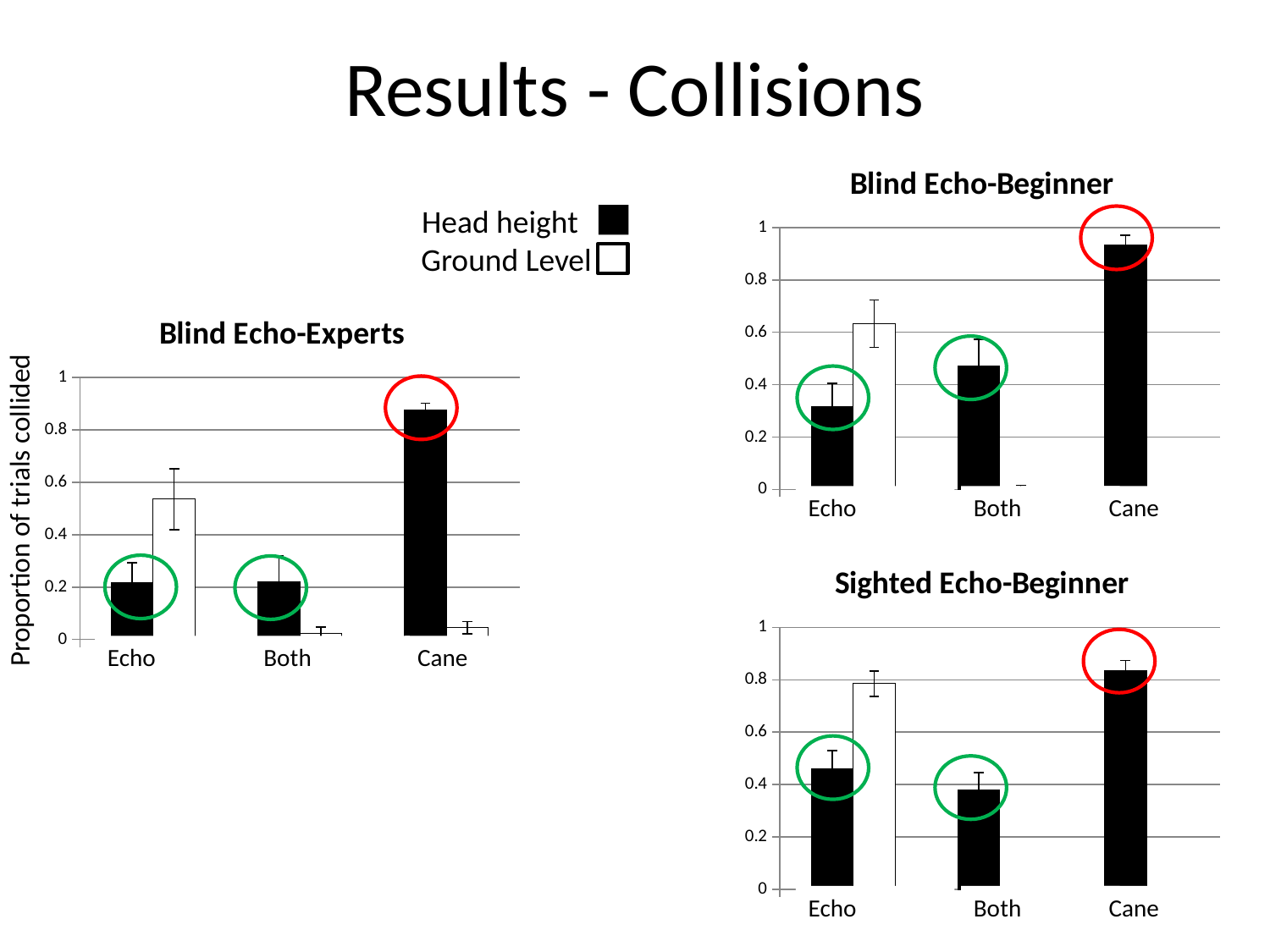
In the Blind Echo-Experts chart, which category has the highest Head height bar? Cane In the Sighted Echo-Beginner chart, which is larger: the Head height bar for Cane or the Head height bar for Both? Cane In the Blind Echo-Beginner chart, is the Head height value for Both greater or less than 0.6? less In the Sighted Echo-Beginner chart, is the Ground Level value for Echo greater or less than 0.6? greater In the Sighted Echo-Beginner chart, which category has the highest Head height bar? Cane In the Blind Echo-Experts chart, for the Echo category, which is larger: the Head height bar or the Ground Level bar? Ground Level In the Blind Echo-Beginner chart, is the Head height value for Cane greater or less than 0.8? greater How many series does the legend on the slide list? 2 How many categories are shown on the x axis of the Blind Echo-Beginner chart? 3 What is the label on the y axis of the Blind Echo-Experts chart? Proportion of trials collided What kind of chart is the Blind Echo-Experts chart? bar chart